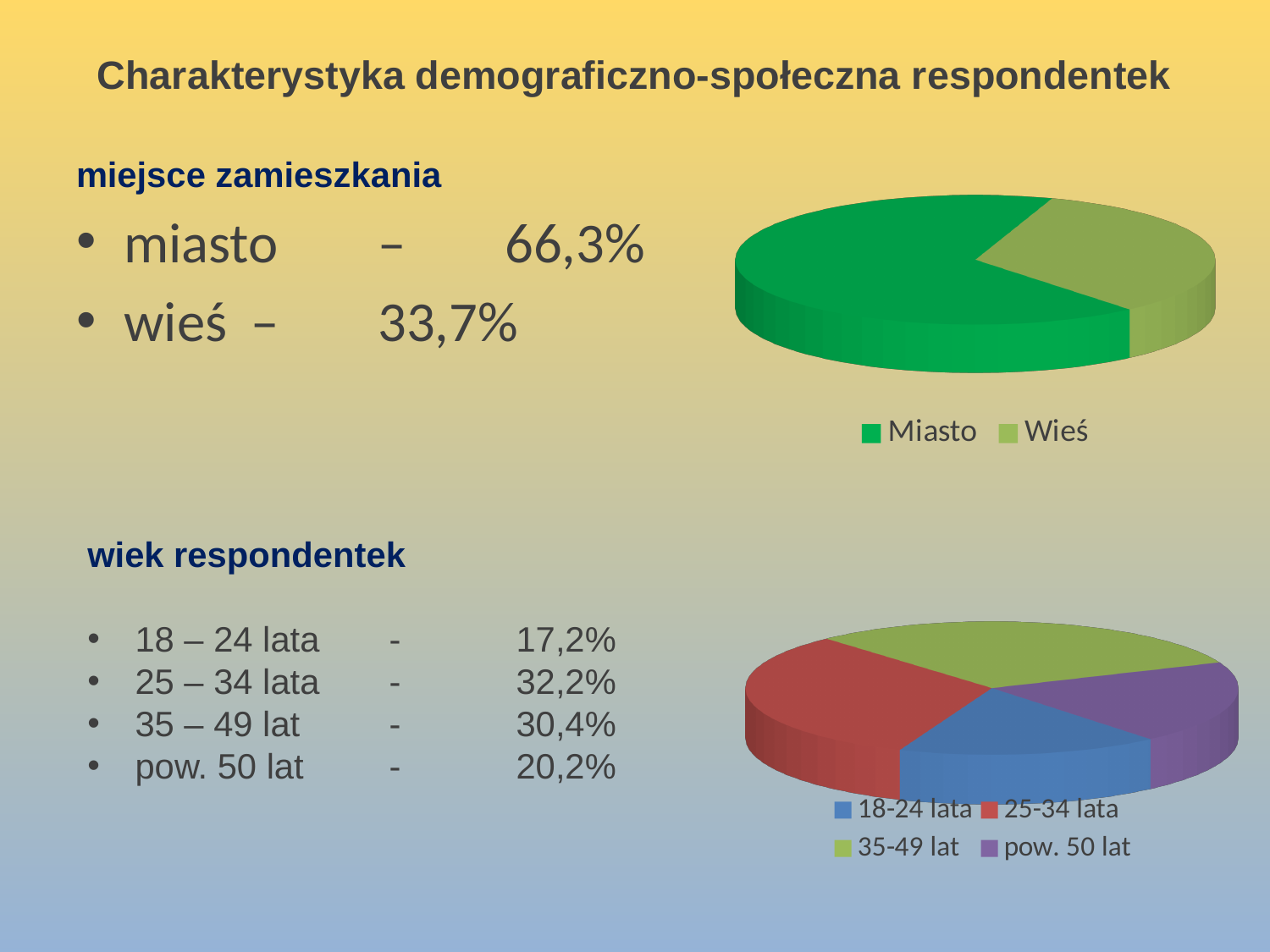
In the lower pie chart (wiek respondentek), which age group has the smallest share? 18-24 lata In the upper pie chart (miejsce zamieszkania), what share of respondents live in the countryside (wieś)? 33,7% In the lower pie chart (wiek respondentek), which colour represents the 35-49 lat group? green What type of chart is the upper chart on the slide (miejsce zamieszkania)? pie chart How many slices does the lower pie chart (wiek respondentek) have? 4 How many entries does the legend of the upper pie chart (miejsce zamieszkania) list? 2 In the upper pie chart (miejsce zamieszkania), what share of respondents live in the city (miasto)? 66,3% In the upper pie chart (miejsce zamieszkania), which category has the larger slice? Miasto In the lower pie chart (wiek respondentek), which age group has the largest share? 25-34 lata In the lower pie chart (wiek respondentek), what is the share of respondents aged pow. 50 lat? 20,2% In the lower pie chart (wiek respondentek), what is the share of respondents aged 25–34 lata? 32,2% In the upper pie chart (miejsce zamieszkania), what is the difference between the miasto and wieś shares? 32,6 percentage points